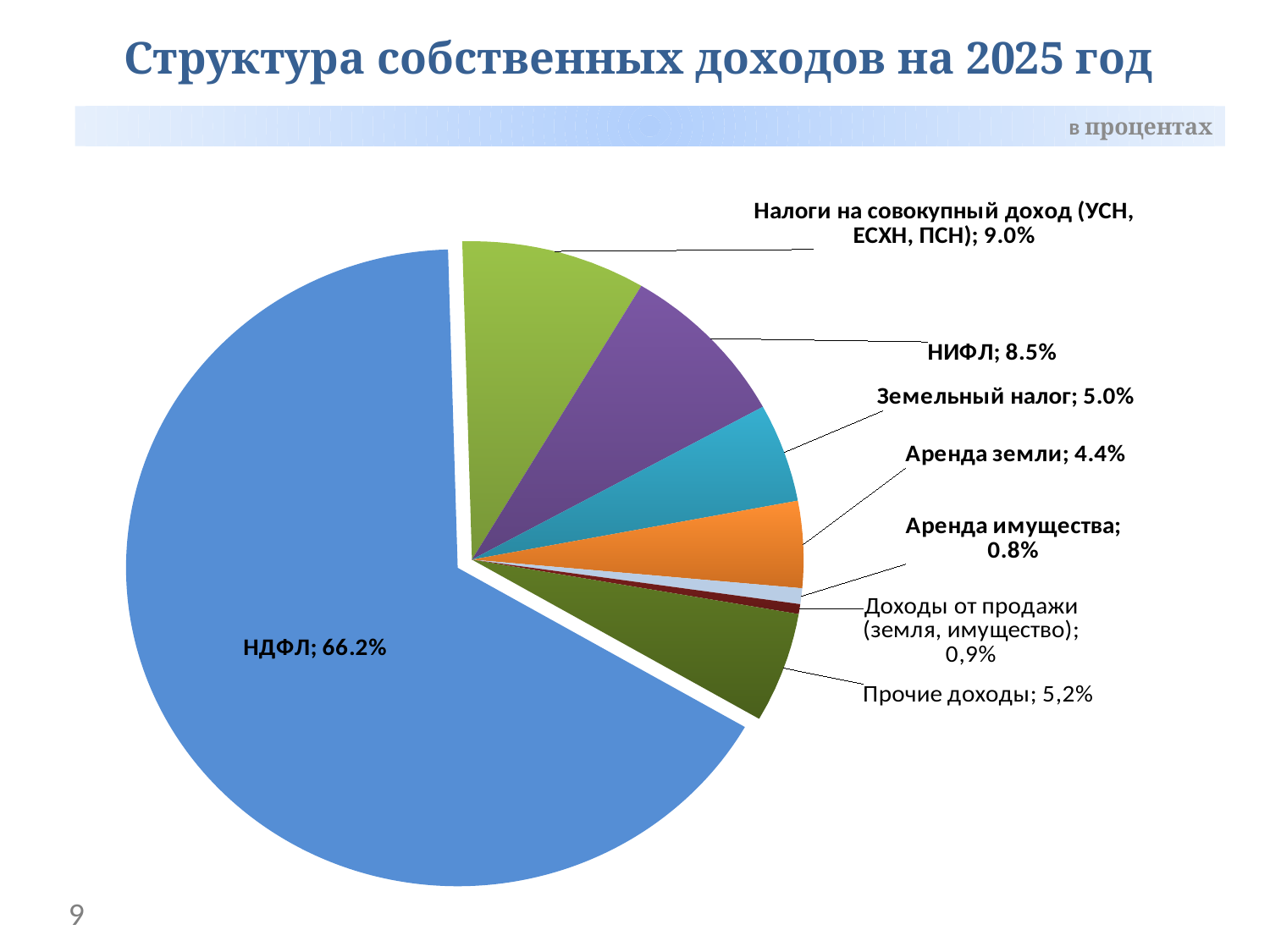
What is the share for Прочие доходы? 5,2% What is the share for Налоги на совокупный доход (УСН, ЕСХН, ПСН)? 9.0% What is the difference between the shares of Налоги на совокупный доход (УСН, ЕСХН, ПСН) and НИФЛ? 0.5% Which category has the largest share of the pie? НДФЛ Which is larger, the share for Земельный налог or the share for Аренда земли? Земельный налог What is the share for НИФЛ? 8.5% What is the share for НДФЛ? 66.2% What is the share for Аренда земли? 4.4% What kind of chart is shown on the slide? pie chart What is the share for Земельный налог? 5.0% How many slices does the pie chart have? 8